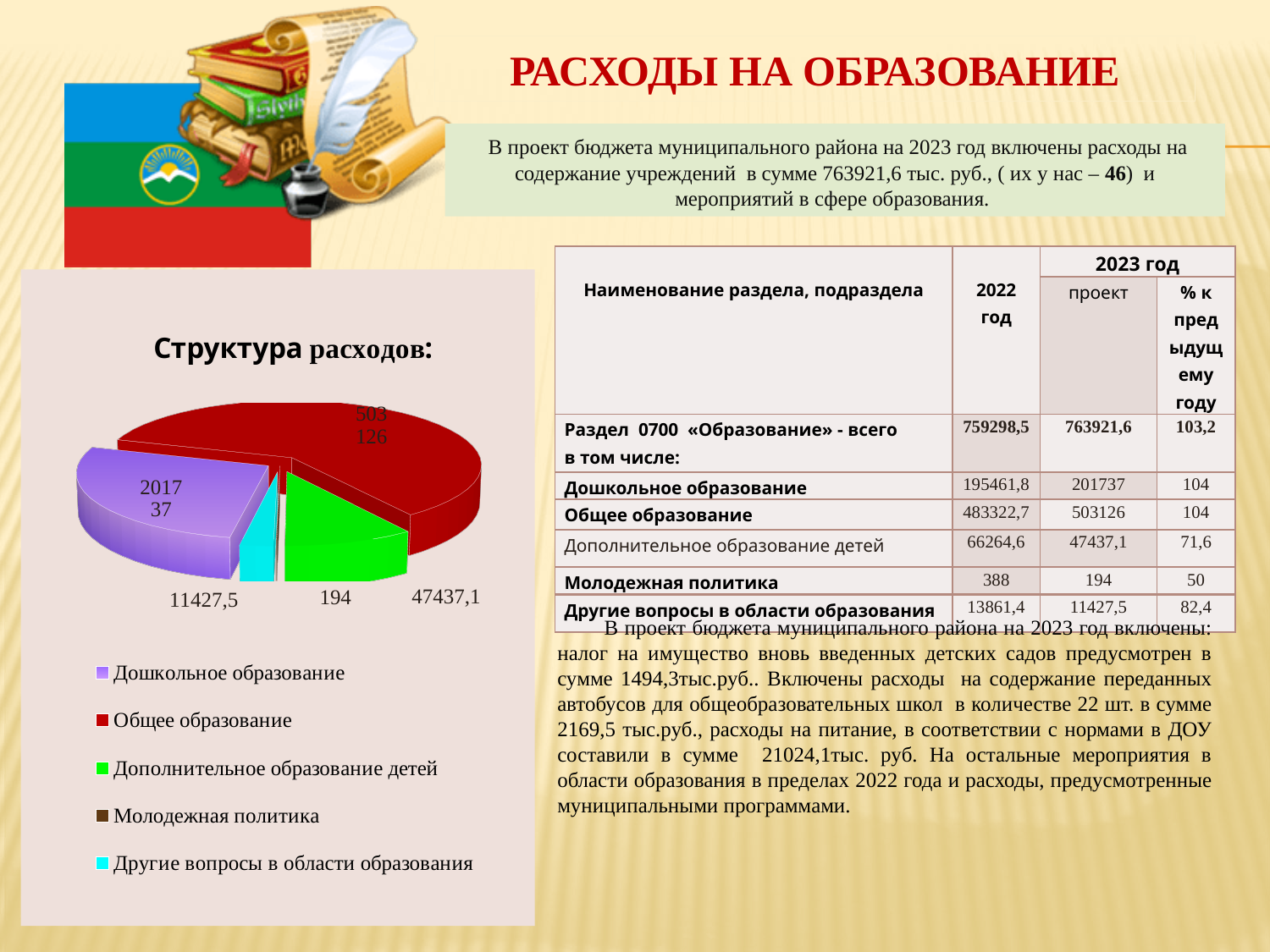
What kind of chart is shown on the slide? pie chart What is the difference between the values for Дополнительное образование детей and Другие вопросы в области образования in the pie chart? 36009,6 Which category has the smallest slice in the pie chart? Молодежная политика Which category has the largest slice in the pie chart? Общее образование Which is larger in the pie chart: Дополнительное образование детей or Другие вопросы в области образования? Дополнительное образование детей What value is shown for Другие вопросы в области образования in the pie chart? 11427,5 What colour represents Общее образование in the pie chart? dark red How many categories does the pie chart show? 5 What value is shown for Дополнительное образование детей in the pie chart? 47437,1 How many entries does the chart legend list? 5 What is the title of the chart? Структура расходов: What value is shown for Молодежная политика in the pie chart? 194